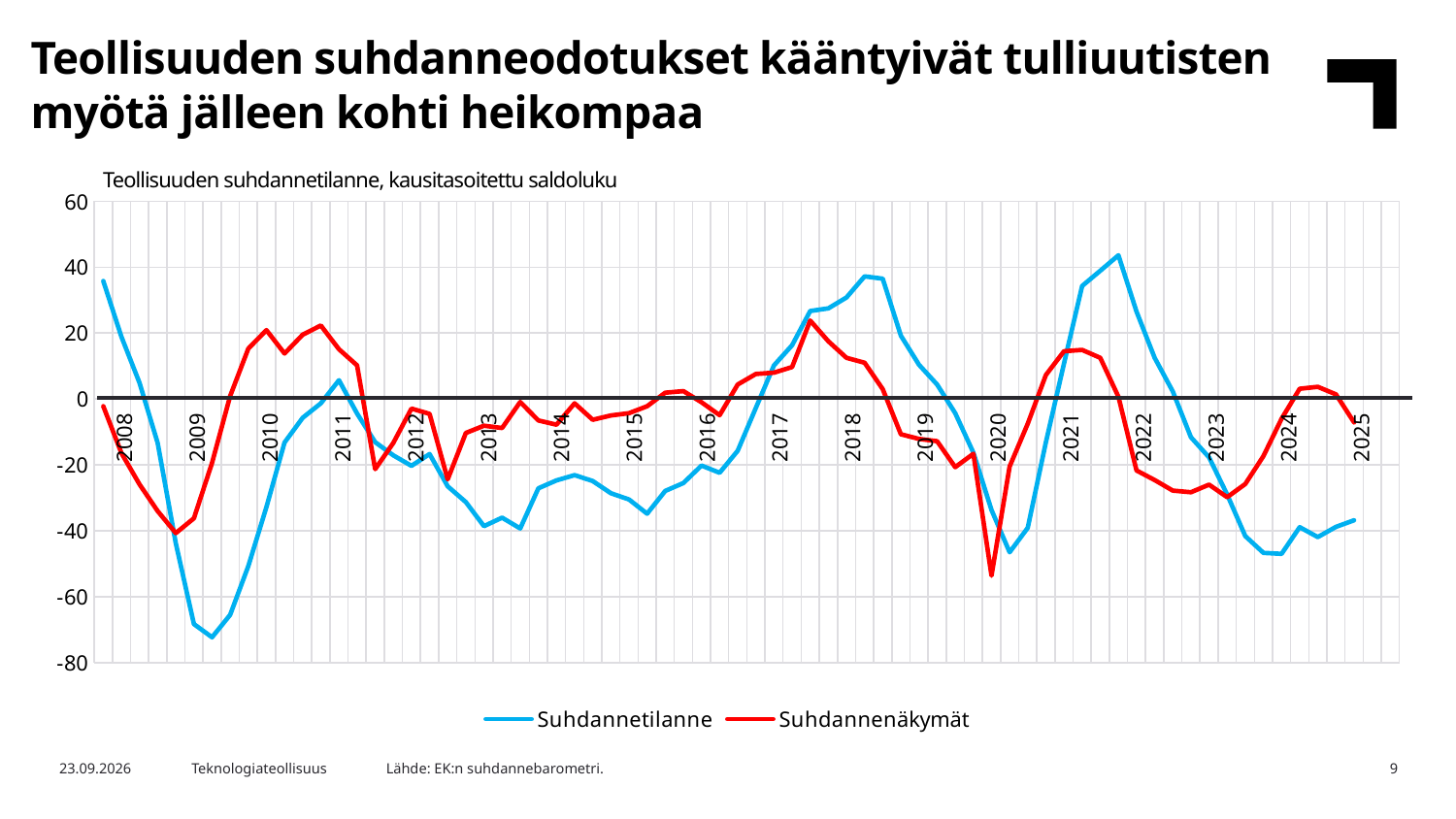
How many series does the legend list? 2 Does Suhdannetilanne rise or fall between 2020 and 2021? rise What are the two series named in the legend? Suhdannetilanne and Suhdannenäkymät Is the lowest value of Suhdannetilanne in 2009 greater or less than -60? less Is the value of Suhdannetilanne at the start of 2008 greater or less than 20? greater How many year labels are shown on the x axis? 18 What is the title printed above the chart? Teollisuuden suhdannetilanne, kausitasoitettu saldoluku What kind of chart is shown on the slide? line chart In which year does Suhdannetilanne reach its lowest point? 2009 Is the lowest value of Suhdannenäkymät in 2020 greater or less than -40? less Does Suhdannetilanne rise or fall between 2022 and 2023? fall In 2009, which series has the lower value, Suhdannetilanne or Suhdannenäkymät? Suhdannetilanne